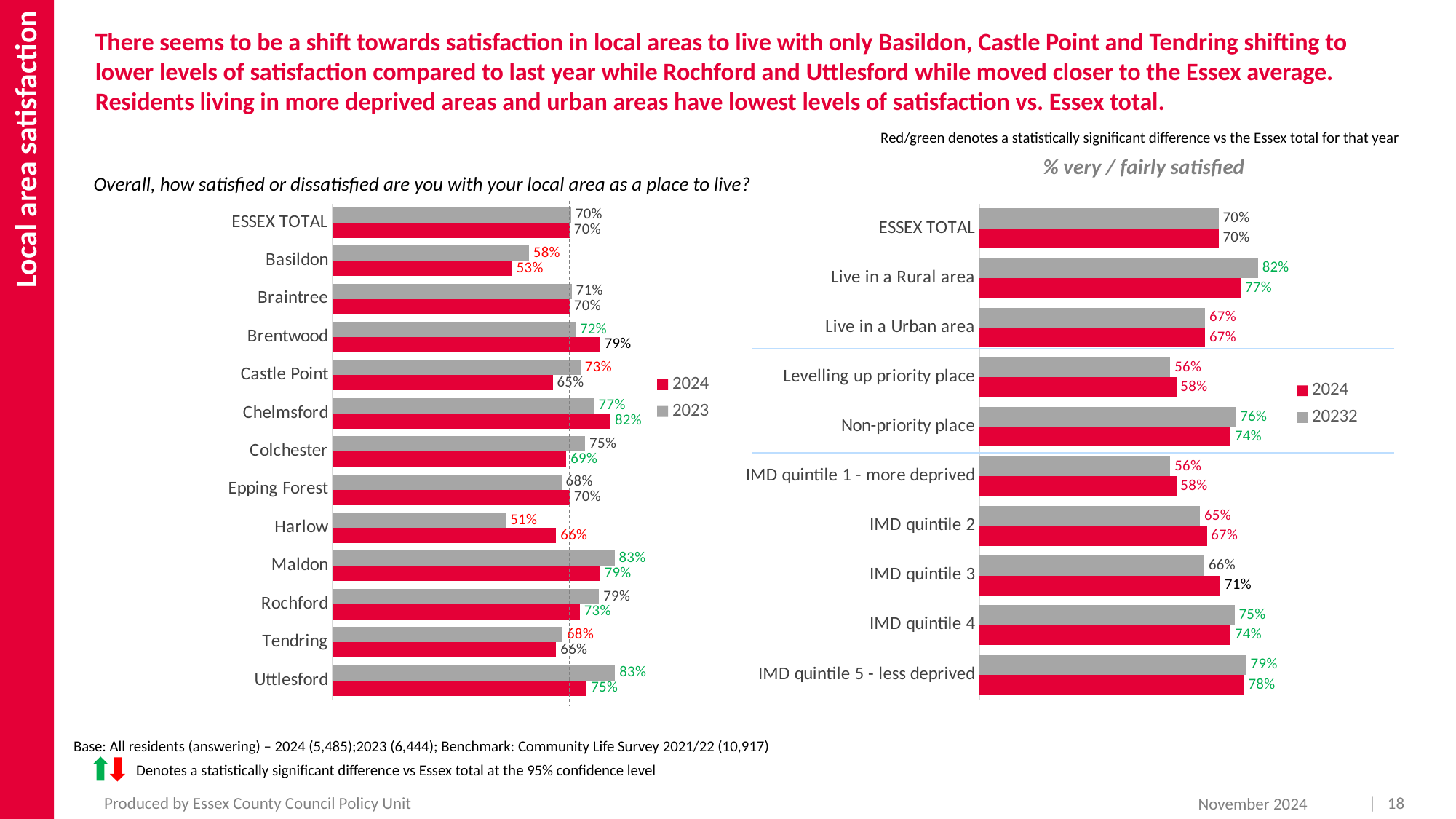
What type of chart is the left chart of district satisfaction? Bar chart How many series does the legend of the right chart (% very / fairly satisfied) list? 2 In the left chart of district satisfaction, which district has the highest 2024 value? Chelmsford In the right chart (% very / fairly satisfied), what is the 2024 value for IMD quintile 3? 71% In the left chart of district satisfaction, which district has the lowest 2024 value? Basildon In the left chart of district satisfaction, what is the difference between the 2024 and 2023 values for Harlow? 15 percentage points How many categories are shown in the left chart of district satisfaction? 13 In the left chart of district satisfaction, what is the 2024 value for Chelmsford? 82% In the left chart of district satisfaction, which is larger for Castle Point: the 2024 value or the 2023 value? 2023 In the left chart of district satisfaction, what is the 2023 value for Harlow? 51% In the right chart (% very / fairly satisfied), what is the difference between the 2023 values for Live in a Rural area and Live in a Urban area? 15 percentage points In the right chart (% very / fairly satisfied), which category has the highest 2023 value? Live in a Rural area